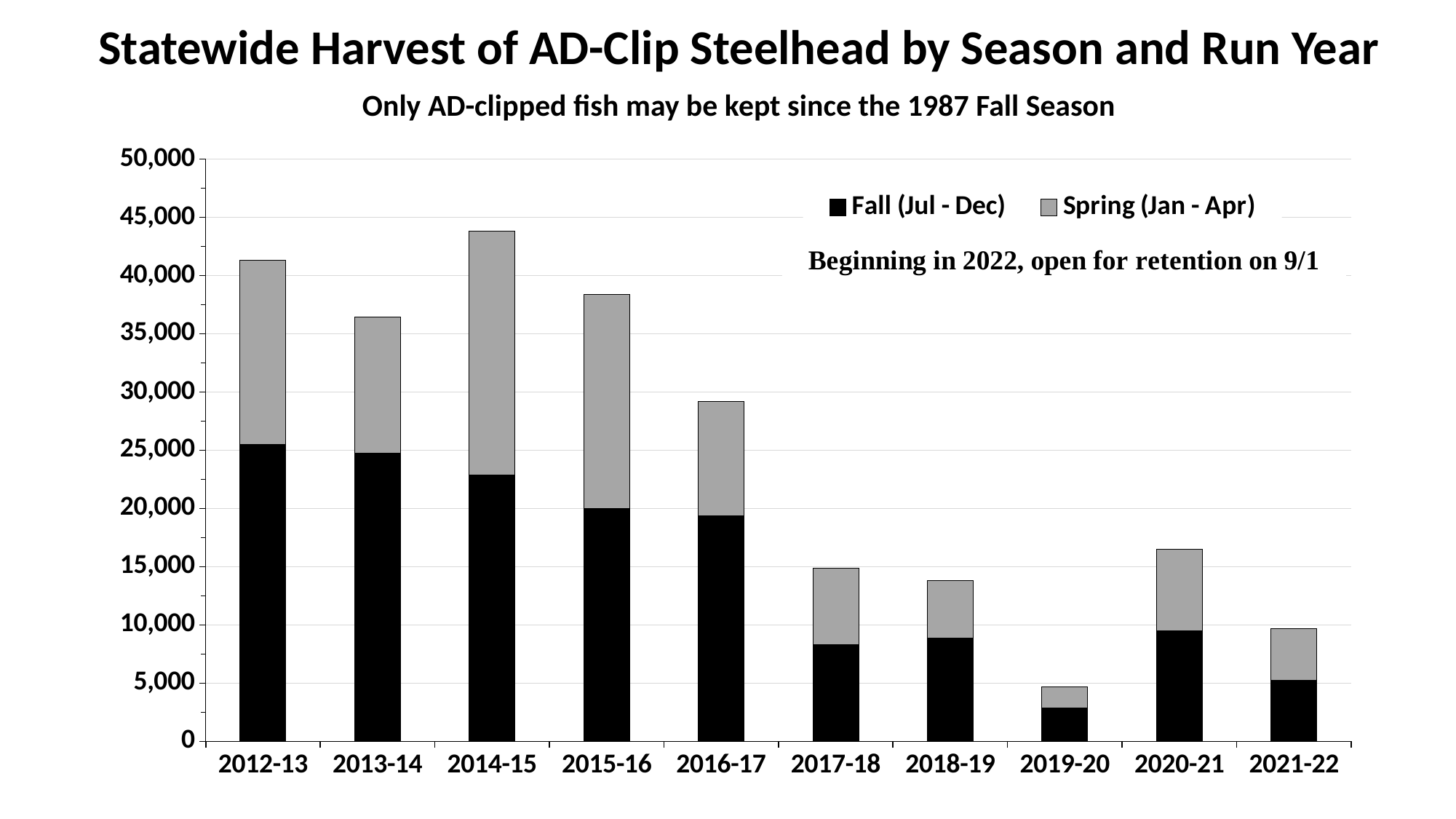
How many series does the legend list? 2 Which has the larger total harvest, 2020-21 or 2021-22? 2020-21 Which run year has the highest total harvest? 2014-15 Which has the larger total harvest, 2012-13 or 2013-14? 2012-13 Overall, does the total harvest rise or fall from 2012-13 to 2021-22? Fall What kind of chart is shown on the slide? Stacked bar chart How many run years are shown on the x axis? 10 Is the total harvest for 2014-15 greater or less than 40,000? greater Which run year has the lowest total harvest? 2019-20 Is the total harvest for 2020-21 greater or less than 15,000? greater Which run year has the lowest Fall (Jul - Dec) harvest? 2019-20